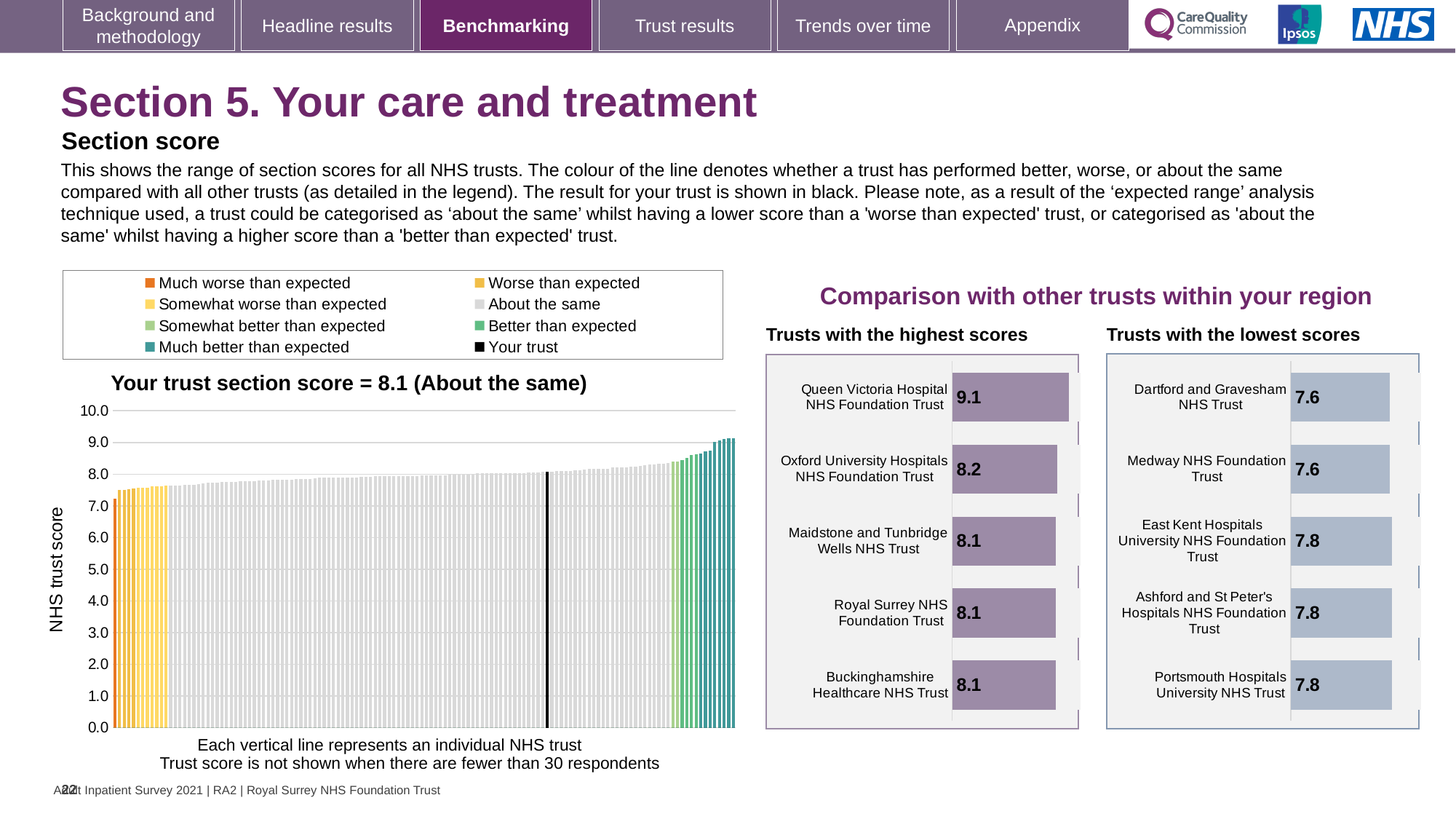
In the 'Your trust section score' chart, what is the section score for your trust? 8.1 In the 'Trusts with the lowest scores' chart, what is the score for Medway NHS Foundation Trust? 7.6 In the 'Trusts with the lowest scores' chart, which is larger: the score for East Kent Hospitals University NHS Foundation Trust or for Dartford and Gravesham NHS Trust? East Kent Hospitals University NHS Foundation Trust In the 'Trusts with the highest scores' chart, what is the score for Queen Victoria Hospital NHS Foundation Trust? 9.1 How many trusts are shown in the 'Trusts with the lowest scores' chart? 5 What is the y-axis label of the 'Your trust section score' chart? NHS trust score In the 'Your trust section score' chart, is the value of the highest (rightmost) bar greater or less than 8.0? greater In the 'Your trust section score' chart, is the value of the lowest (leftmost) bar greater or less than 8.0? less In the 'Trusts with the highest scores' chart, which trust has the highest score? Queen Victoria Hospital NHS Foundation Trust What kind of chart is the 'Your trust section score' chart? bar chart How many entries does the legend above the 'Your trust section score' chart list? 8 In the 'Trusts with the highest scores' chart, what is the difference between the scores of Queen Victoria Hospital NHS Foundation Trust and Oxford University Hospitals NHS Foundation Trust? 0.9